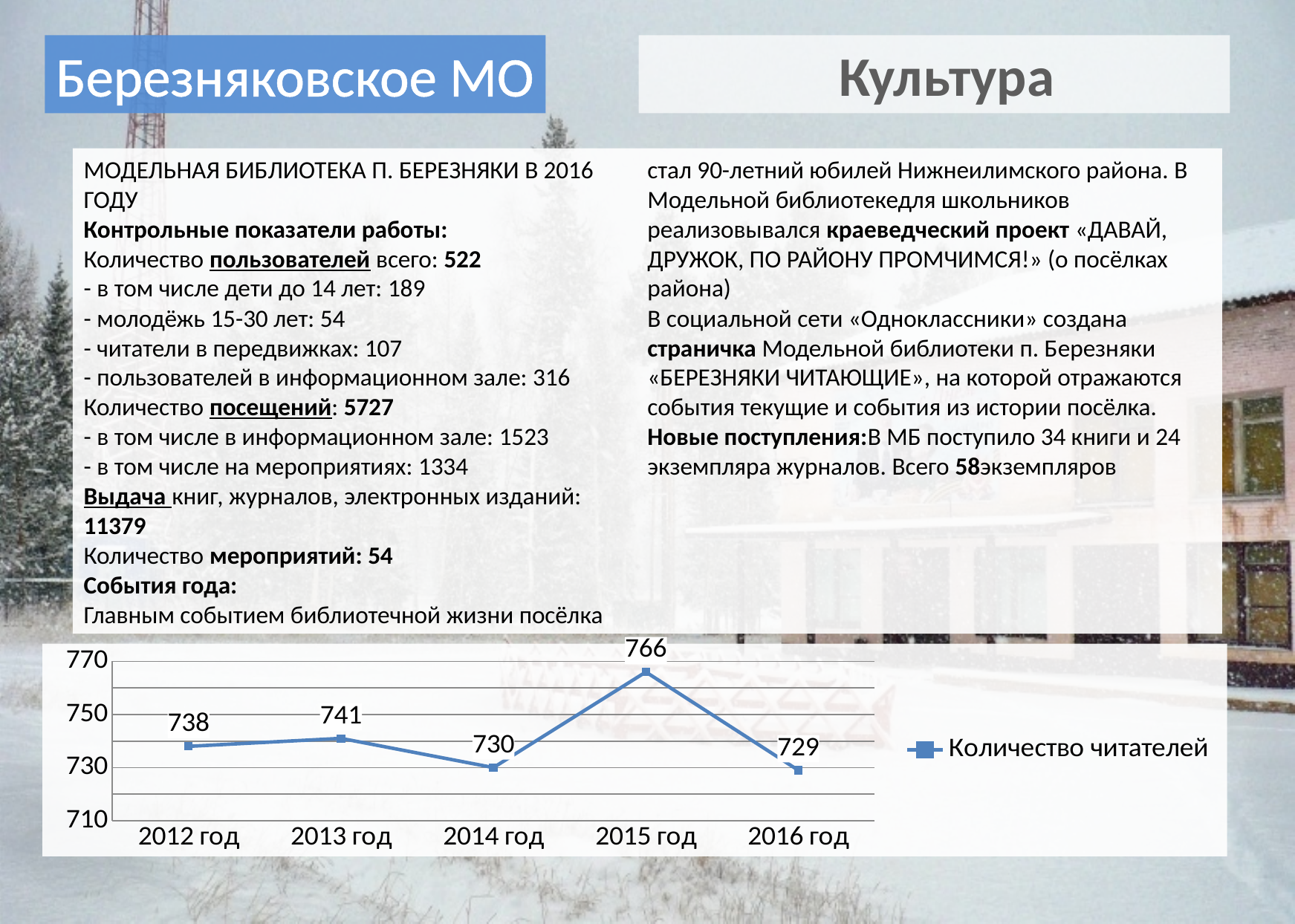
What is the value for 2016 год in the line chart? 729 Which year has the highest value in the line chart? 2015 год What is the value for 2015 год in the line chart? 766 Which year has the lowest value in the line chart? 2016 год What series name does the chart legend show? Количество читателей What is the difference between the values for 2015 год and 2016 год? 37 What kind of chart is shown on the slide? line chart Is the value for 2015 год greater or less than 750? greater How many years are plotted in the line chart? 5 Which is larger, the value for 2014 год or the value for 2013 год? 2013 год What is the value for 2012 год in the line chart? 738 What is the difference between the values for 2013 год and 2012 год? 3